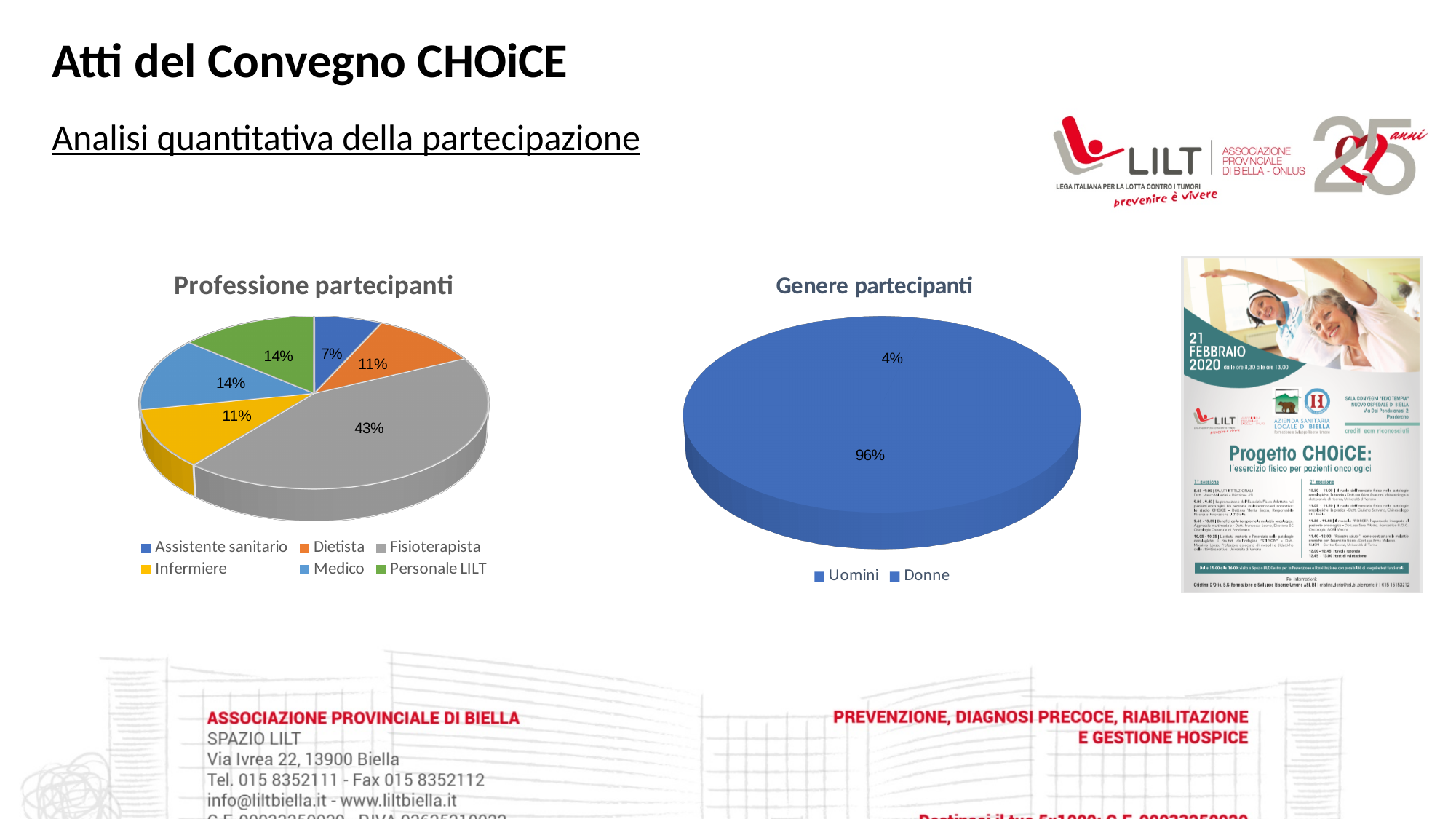
How many categories does the 'Professione partecipanti' chart show? 6 In the 'Professione partecipanti' chart, what share of participants are Assistente sanitario? 7% In the 'Genere partecipanti' chart, what share of participants are Donne? 96% In the 'Professione partecipanti' chart, which profession has the smallest share? Assistente sanitario In the 'Professione partecipanti' chart, which is larger, the share for Medico or the share for Infermiere? Medico In the 'Professione partecipanti' chart, which profession has the largest share? Fisioterapista In the 'Professione partecipanti' chart, what is the difference in percentage points between Fisioterapista and Dietista? 32 In the 'Professione partecipanti' chart, what share of participants are Medico? 14% In the 'Professione partecipanti' chart, which colour represents Personale LILT? Green In the 'Genere partecipanti' chart, what share of participants are Uomini? 4% What type of chart is 'Genere partecipanti'? Pie chart In the 'Professione partecipanti' chart, what share of participants are Fisioterapista? 43%